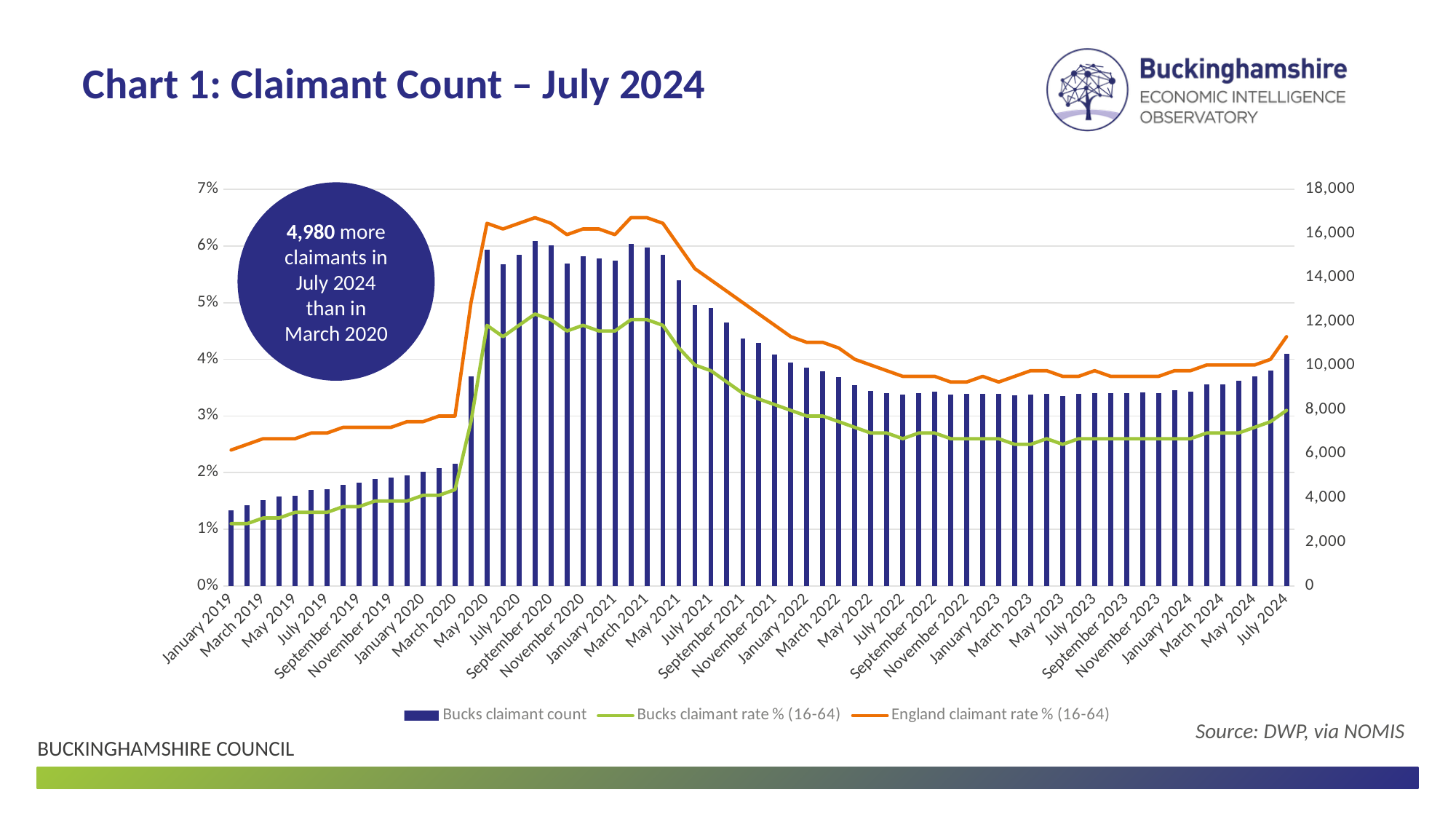
What kind of chart is shown on the slide? A combined bar and line chart Is the England claimant rate % (16-64) for July 2024 greater or less than 4%? greater Is the Bucks claimant count for July 2024 greater or less than 8,000? greater Is the Bucks claimant count for May 2020 greater or less than 14,000? greater Which month has the lowest Bucks claimant count? January 2019 Which series is plotted as bars? Bucks claimant count What is the title of the chart? Chart 1: Claimant Count – July 2024 Does the Bucks claimant count rise or fall between September 2020 and July 2022? fall In July 2024, which is higher: the England claimant rate % (16-64) or the Bucks claimant rate % (16-64)? England claimant rate % (16-64) How many series does the legend list? 3